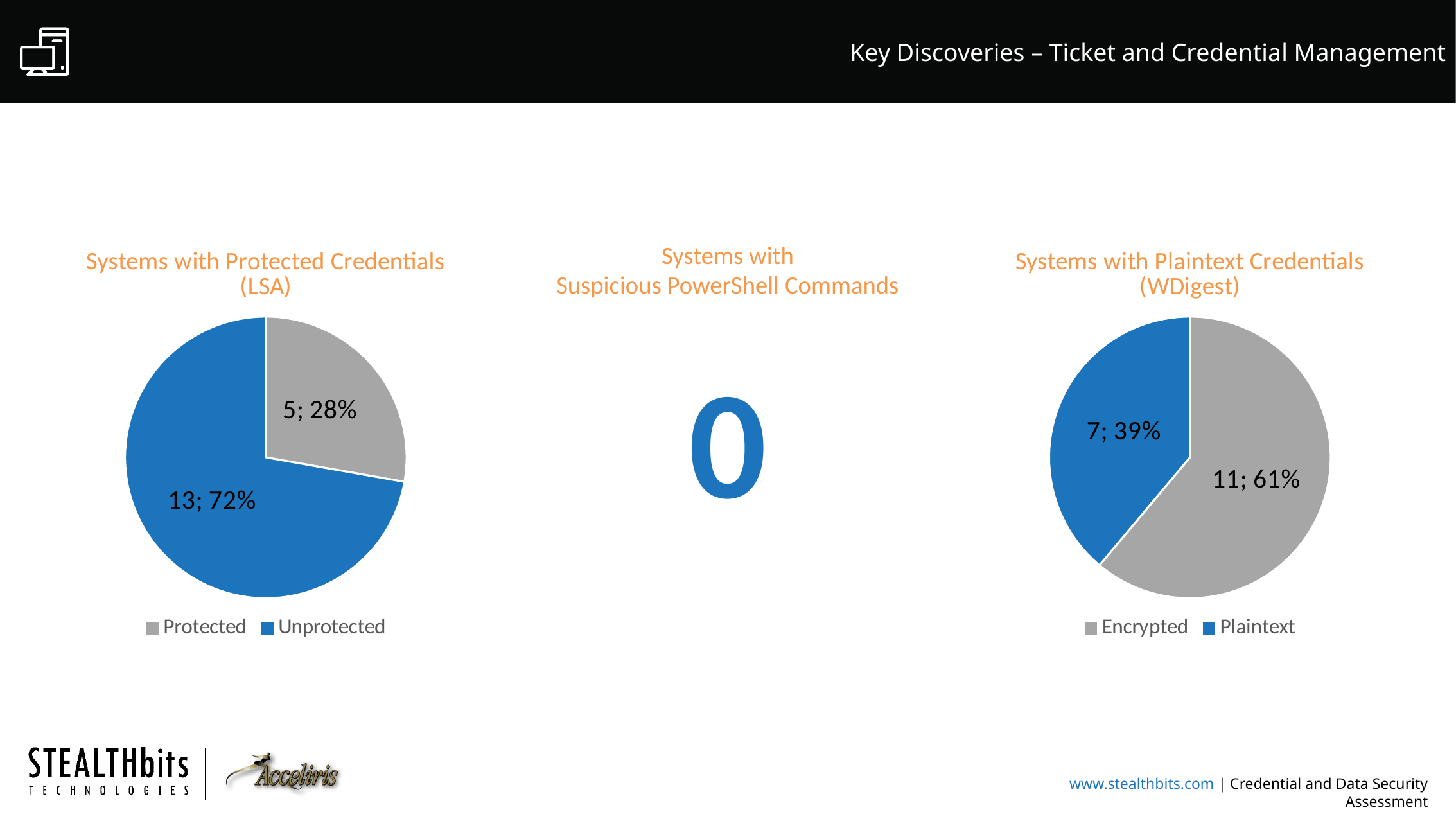
How many entries does the legend of the 'Systems with Plaintext Credentials (WDigest)' chart list? 2 In the 'Systems with Protected Credentials (LSA)' chart, which category is the largest? Unprotected In the 'Systems with Protected Credentials (LSA)' chart, what is the difference between the Unprotected and Protected counts? 8 In the 'Systems with Protected Credentials (LSA)' chart, what percentage of systems are Protected? 28% In the 'Systems with Plaintext Credentials (WDigest)' chart, which category is the smallest? Plaintext In the 'Systems with Protected Credentials (LSA)' chart, how many systems are Unprotected? 13 In the 'Systems with Plaintext Credentials (WDigest)' chart, what colour is the Encrypted slice? grey In the 'Systems with Plaintext Credentials (WDigest)' chart, how many systems are Encrypted? 11 In the 'Systems with Plaintext Credentials (WDigest)' chart, is the Encrypted count larger or smaller than the Plaintext count? larger In the 'Systems with Plaintext Credentials (WDigest)' chart, what percentage of systems are Plaintext? 39% In the 'Systems with Protected Credentials (LSA)' chart, what is the total number of systems across both slices? 18 What kind of chart is 'Systems with Protected Credentials (LSA)'? pie chart